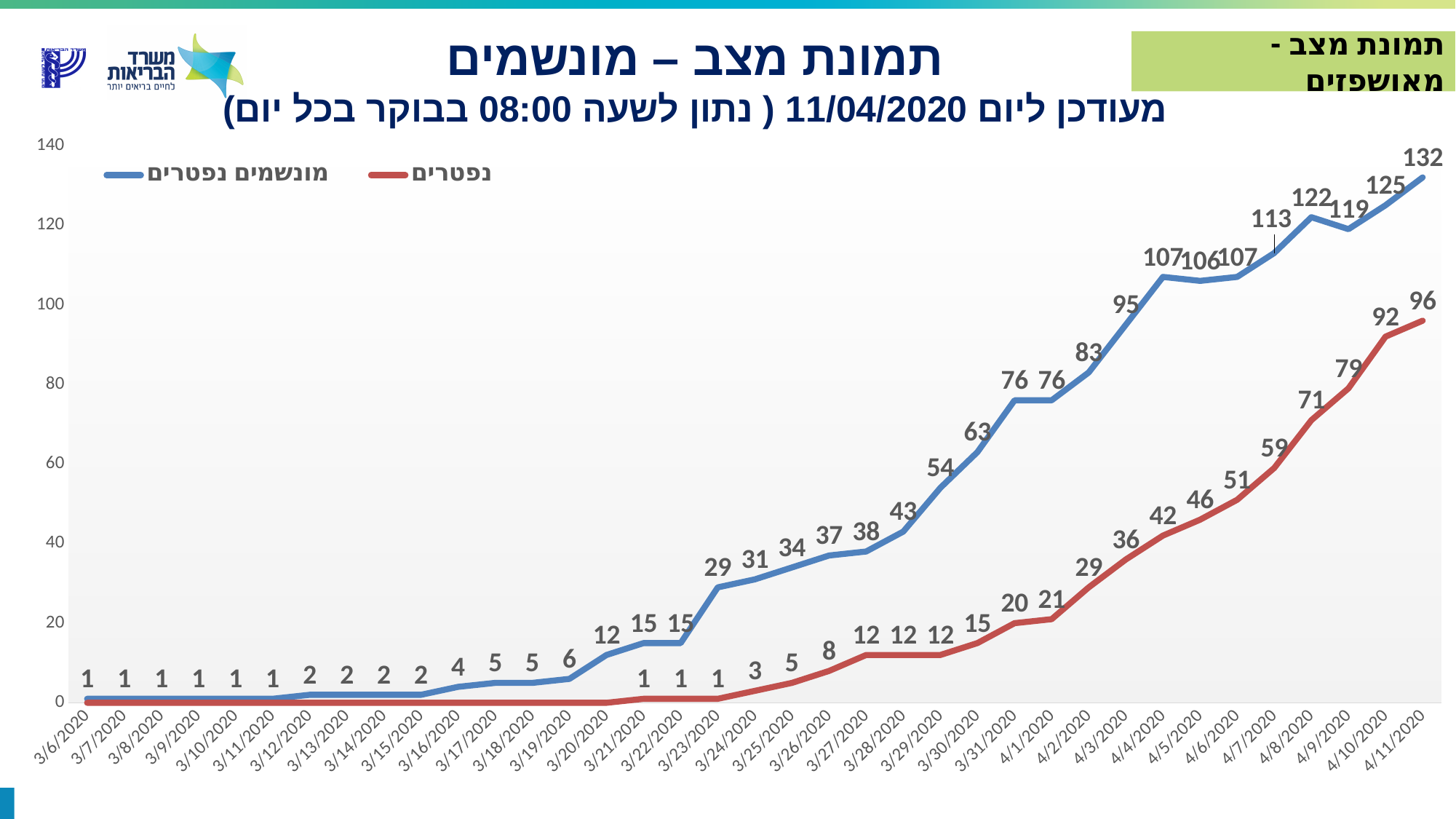
What is the difference between the blue series (מונשמים) and the red series (נפטרים) on 4/11/2020? 36 What is the value of the red series (נפטרים) on 4/11/2020? 96 Does the red series (נפטרים) generally rise or fall from 3/21/2020 to 4/11/2020? rise What is the value of the blue series (מונשמים) on 4/11/2020? 132 Which series has the larger value on 4/8/2020, the blue (מונשמים) or the red (נפטרים)? blue (מונשמים) How many dates are shown on the x axis? 37 Is the value of the blue series (מונשמים) on 4/3/2020 greater or less than 100? less What is the value of the red series (נפטרים) on 4/4/2020? 42 What type of chart is shown on the slide? line chart What is the value of the blue series (מונשמים) on 3/23/2020? 29 How many series does the legend list? 2 On which date does the blue series (מונשמים) reach its highest value? 4/11/2020